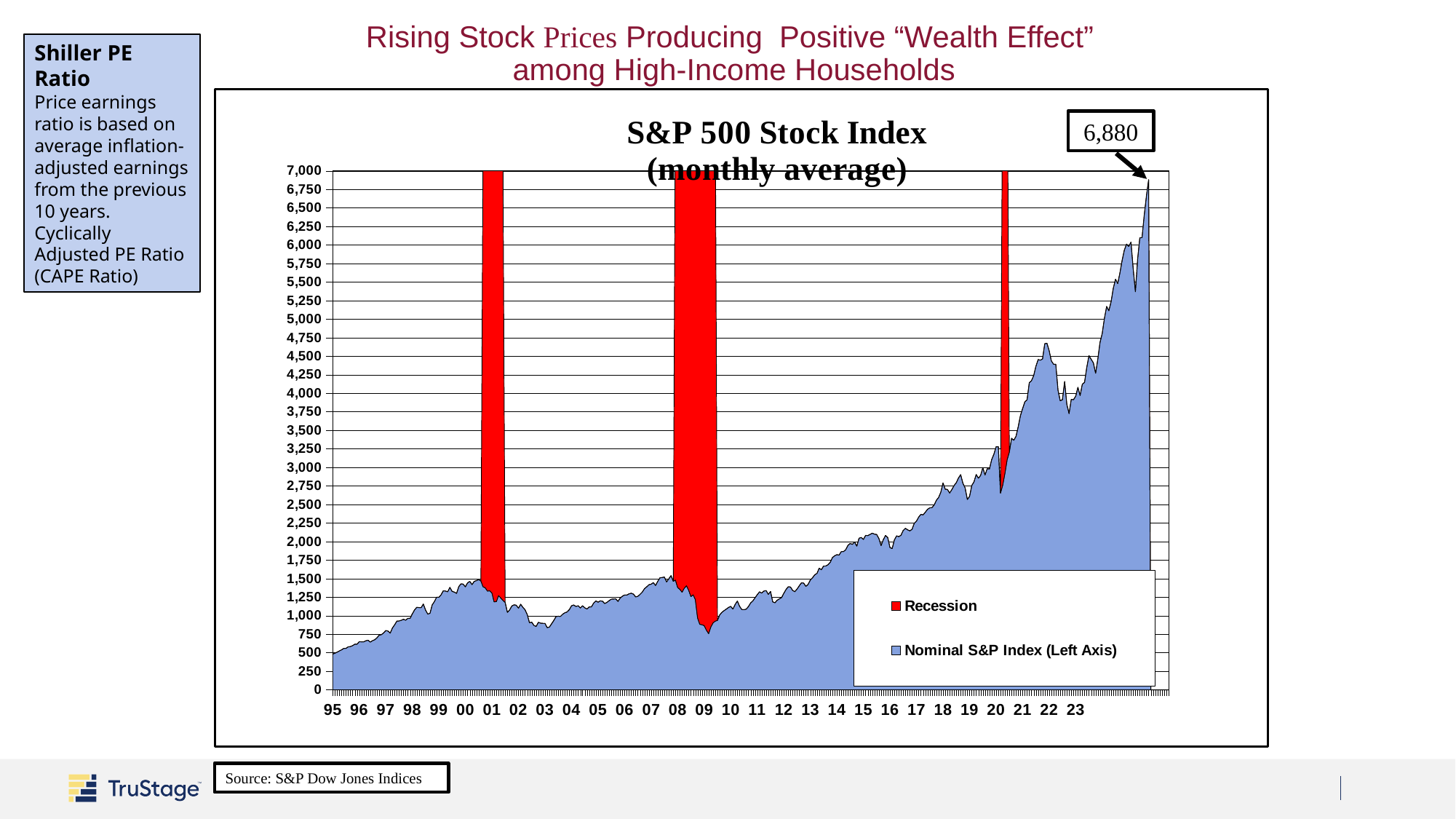
Is the lowest value of the S&P 500 index during the 09 recession greater or less than 1,000? less What is the title of the chart? S&P 500 Stock Index (monthly average) How many series does the legend list? 2 What is the highest value reached by the S&P 500 index on the chart? 6,880 Is the peak value of the S&P 500 index around 22 greater or less than 4,000? greater Overall, does the S&P 500 index rise or fall from 95 to the end of the chart? rise How many recession periods are shaded on the chart? 3 What are the two entries in the chart's legend? Recession; Nominal S&P Index (Left Axis) What kind of chart is shown on the slide? area chart Which is larger, the S&P 500 index value in 13 or in 03? 13 What value is labeled at the end of the S&P 500 series? 6,880 Is the value of the S&P 500 index at the start of 95 greater or less than 1,000? less